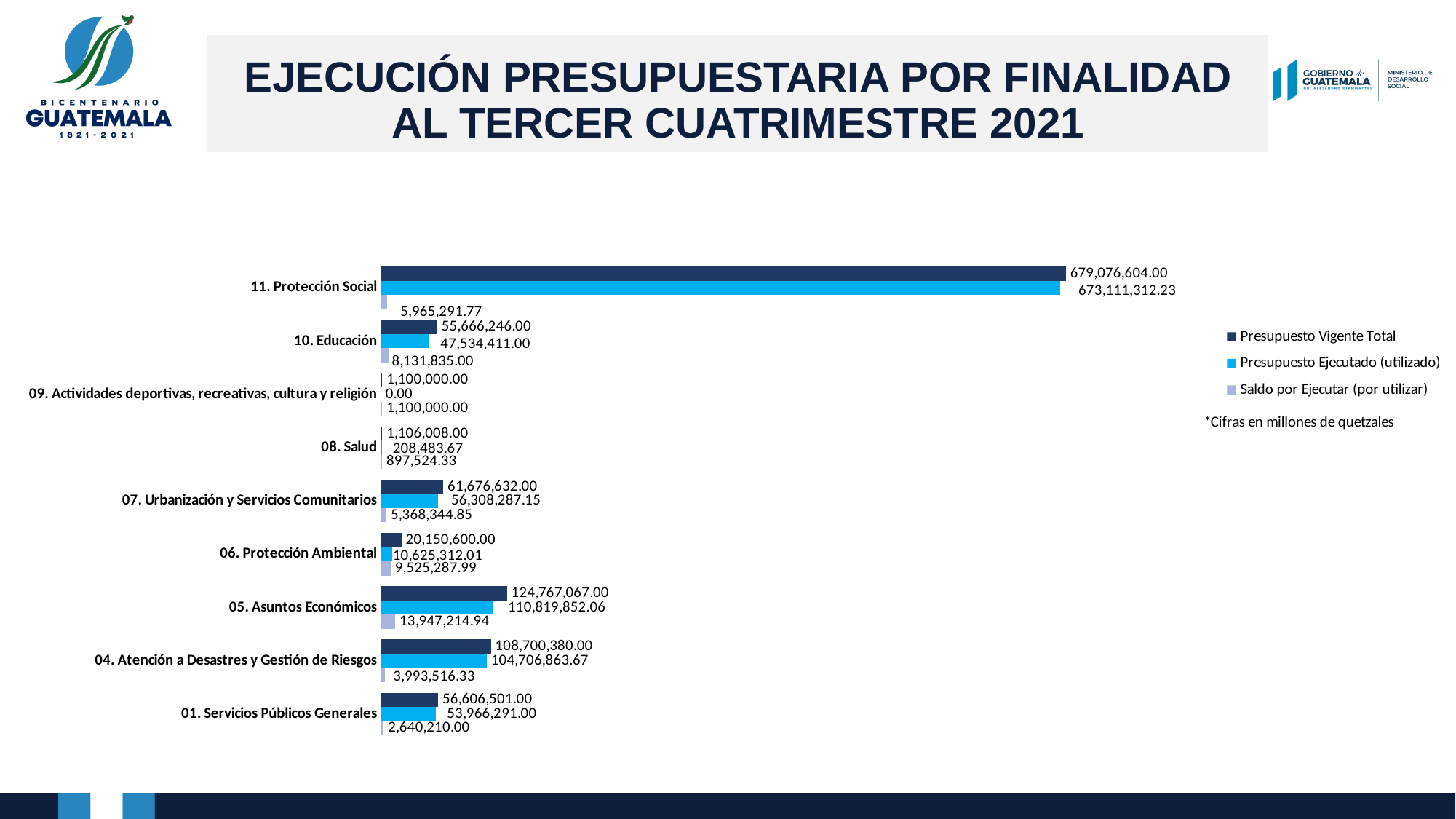
What is the Presupuesto Ejecutado (utilizado) for 08. Salud? 208,483.67 What is the Saldo por Ejecutar (por utilizar) for 06. Protección Ambiental? 9,525,287.99 What kind of chart is shown on the slide? Bar chart What is the Presupuesto Vigente Total for 11. Protección Social? 679,076,604.00 Which series is shown in light blue (cyan) on the chart? Presupuesto Ejecutado (utilizado) Which category has the lowest Presupuesto Ejecutado (utilizado)? 09. Actividades deportivas, recreativas, cultura y religión Which category has the highest Presupuesto Vigente Total? 11. Protección Social What is the difference between the Presupuesto Vigente Total and the Presupuesto Ejecutado (utilizado) for 10. Educación? 8,131,835.00 What is the Presupuesto Ejecutado (utilizado) for 05. Asuntos Económicos? 110,819,852.06 Which has the larger Presupuesto Vigente Total: 05. Asuntos Económicos or 04. Atención a Desastres y Gestión de Riesgos? 05. Asuntos Económicos How many categories are shown on the chart? 9 How many series does the legend list? 3